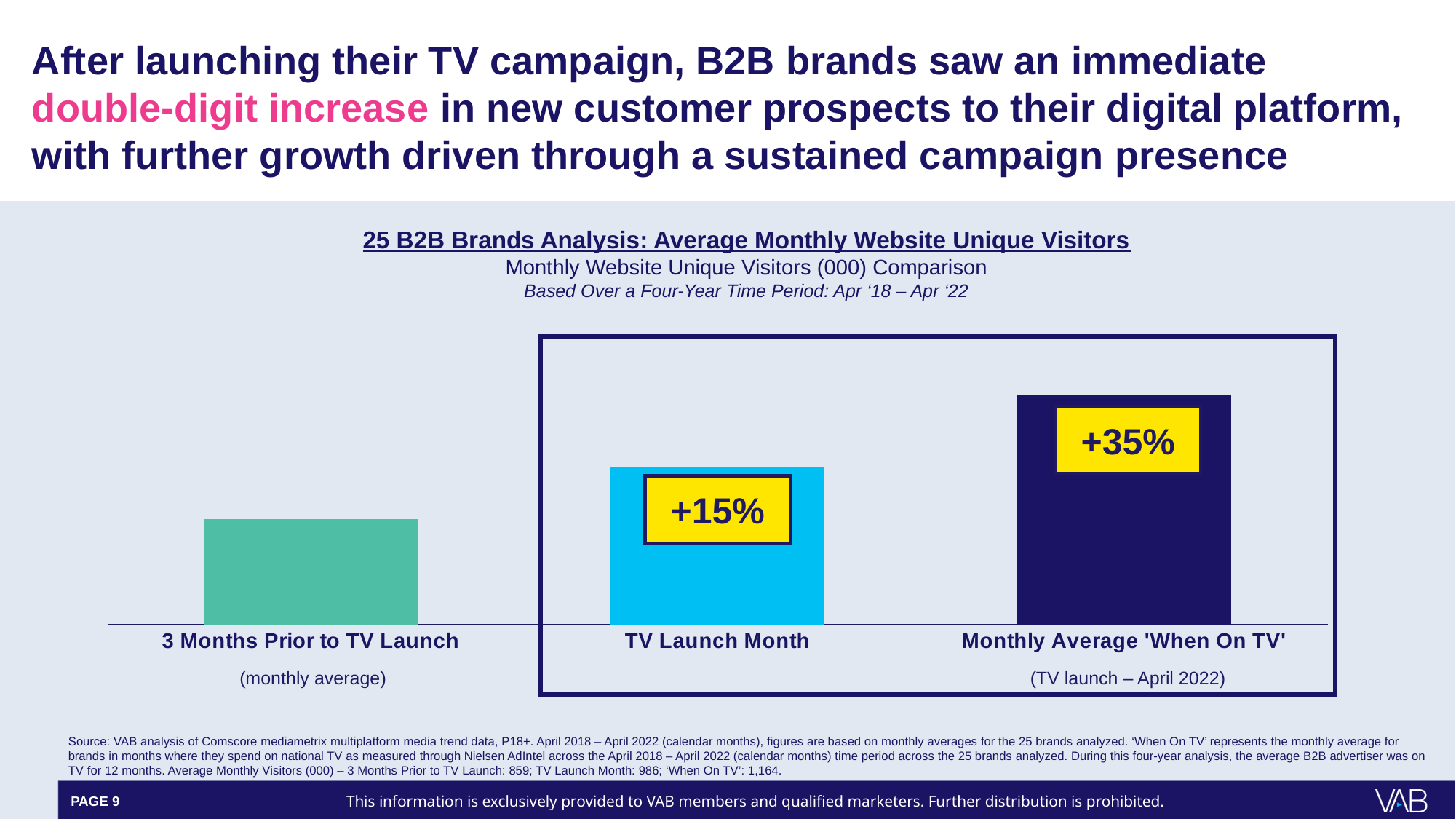
What colour is the bar for 3 Months Prior to TV Launch? green According to the source note, what was the average monthly visitors (000) figure for TV Launch Month? 986 Which bar is taller: TV Launch Month or 3 Months Prior to TV Launch? TV Launch Month What is the underlined title of the chart? 25 B2B Brands Analysis: Average Monthly Website Unique Visitors What is the difference in percentage points between the +35% label and the +15% label? 20 percentage points How many bars are plotted in the chart? 3 Which category has the tallest bar? Monthly Average 'When On TV' What kind of chart is shown on the slide? bar chart What percentage label is shown on the TV Launch Month bar? +15% Do the bar values rise or fall from left to right across the chart? rise Which category has the shortest bar? 3 Months Prior to TV Launch What percentage label is shown on the Monthly Average 'When On TV' bar? +35%